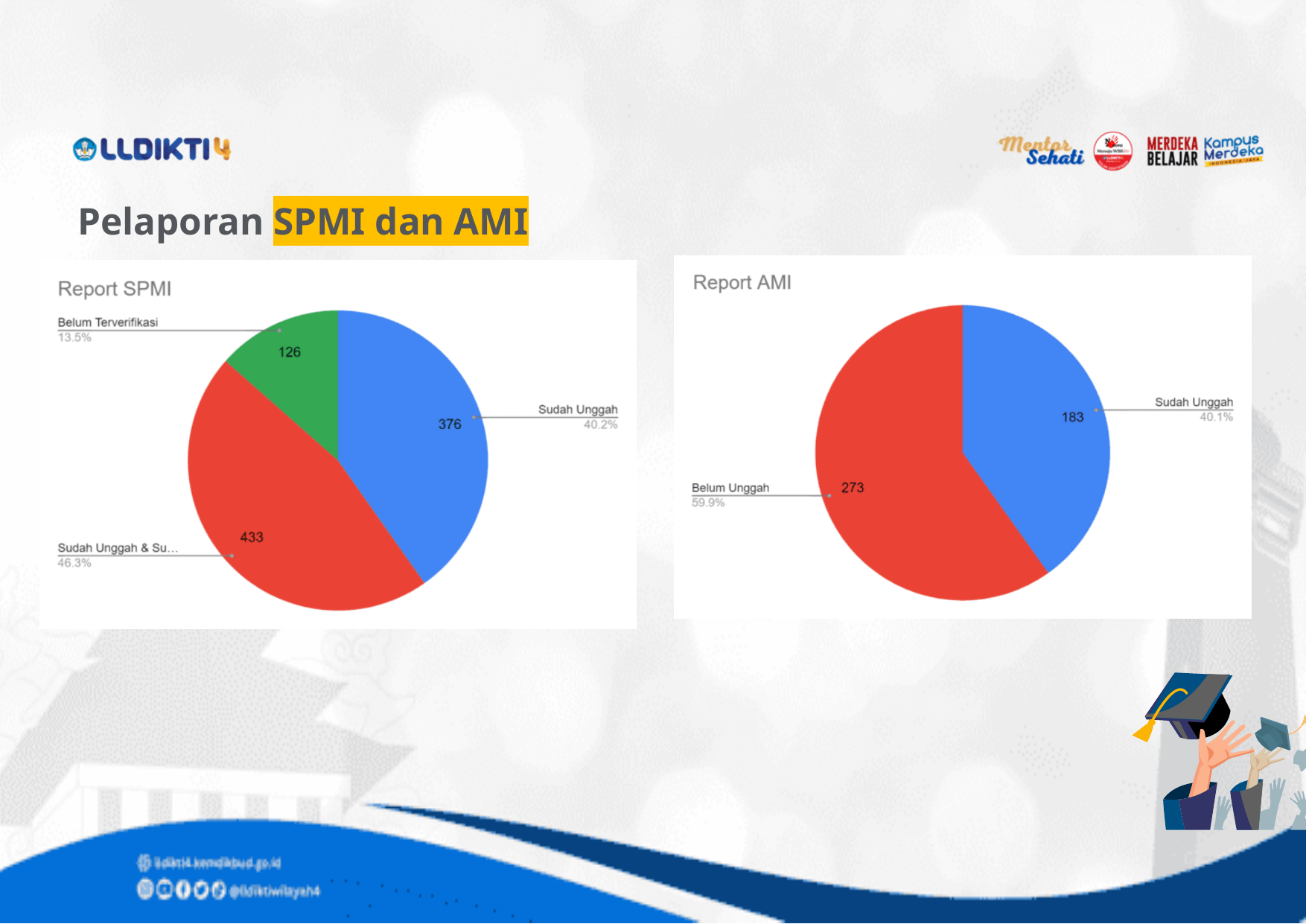
In the Report SPMI chart, what percentage share does Belum Terverifikasi have? 13.5% In the Report SPMI chart, how many slices does the pie have? 3 In the Report AMI chart, what value is shown for Belum Unggah? 273 In the Report AMI chart, what percentage share does Belum Unggah have? 59.9% In the Report AMI chart, what value is shown for Sudah Unggah? 183 In the Report SPMI chart, what value is shown for Sudah Unggah? 376 In the Report SPMI chart, what value is shown for Belum Terverifikasi? 126 What type of chart is the Report AMI chart? Pie chart In the Report SPMI chart, what value is shown on the largest slice? 433 In the Report AMI chart, what is the difference between Belum Unggah and Sudah Unggah? 90 In the Report SPMI chart, what percentage share does Sudah Unggah have? 40.2% In the Report SPMI chart, which category has the smallest slice? Belum Terverifikasi